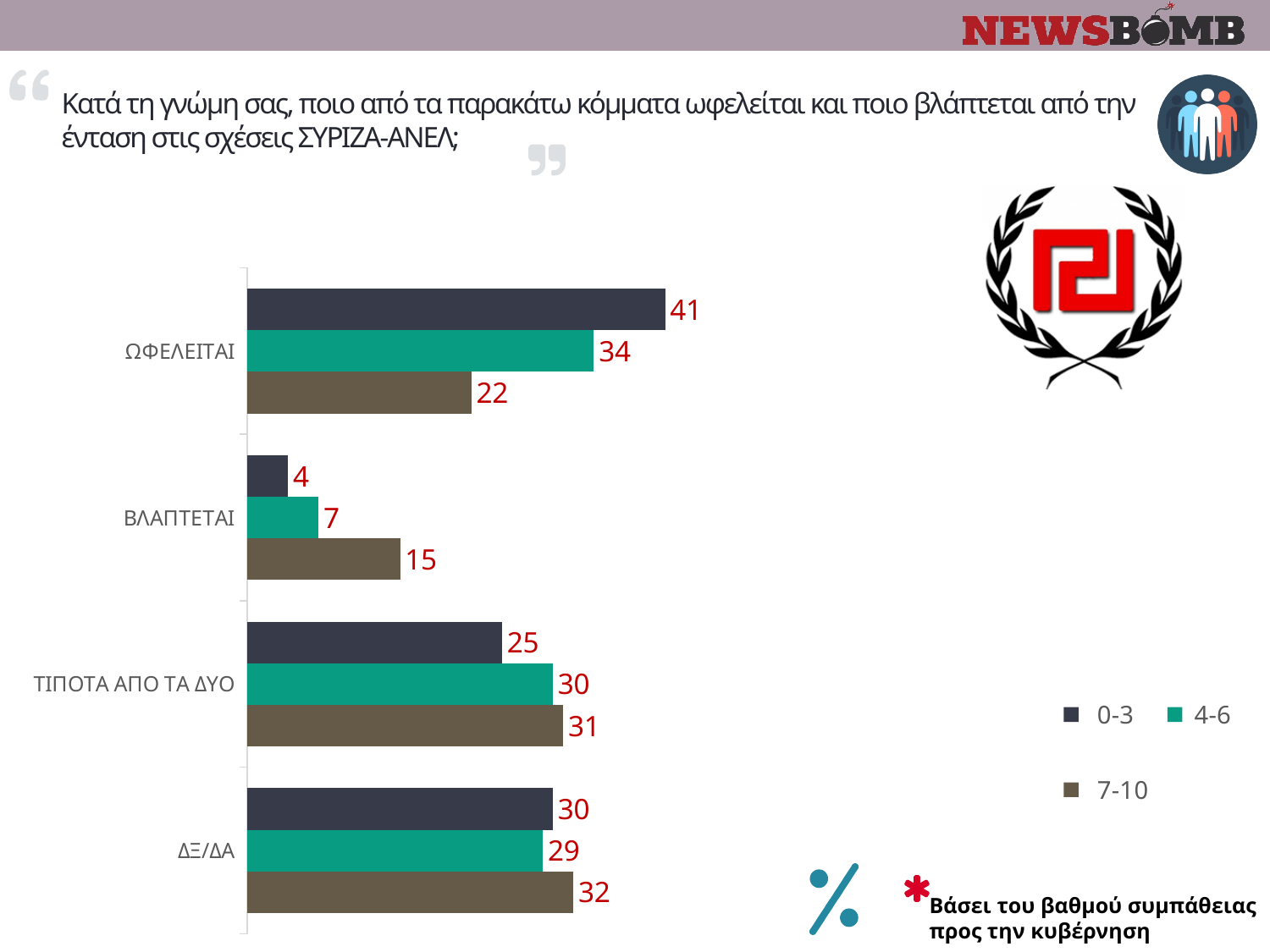
What is the value for ΔΞ/ΔΑ in the 7-10 series? 32 Which is larger for ΒΛΑΠΤΕΤΑΙ: the 4-6 value or the 7-10 value? 7-10 Which category has the lowest value in the 4-6 series? ΒΛΑΠΤΕΤΑΙ Which category has the highest value in the 0-3 series? ΩΦΕΛΕΙΤΑΙ What is the value for ΒΛΑΠΤΕΤΑΙ in the 7-10 series? 15 How many categories are shown on the chart? 4 What kind of chart is shown on the slide? Bar chart How many series does the legend list? 3 Which series is shown in teal in the legend? 4-6 What is the difference between the 0-3 and 7-10 values for ΩΦΕΛΕΙΤΑΙ? 19 What is the value for ΤΙΠΟΤΑ ΑΠΟ ΤΑ ΔΥΟ in the 4-6 series? 30 What is the value for ΩΦΕΛΕΙΤΑΙ in the 0-3 series? 41